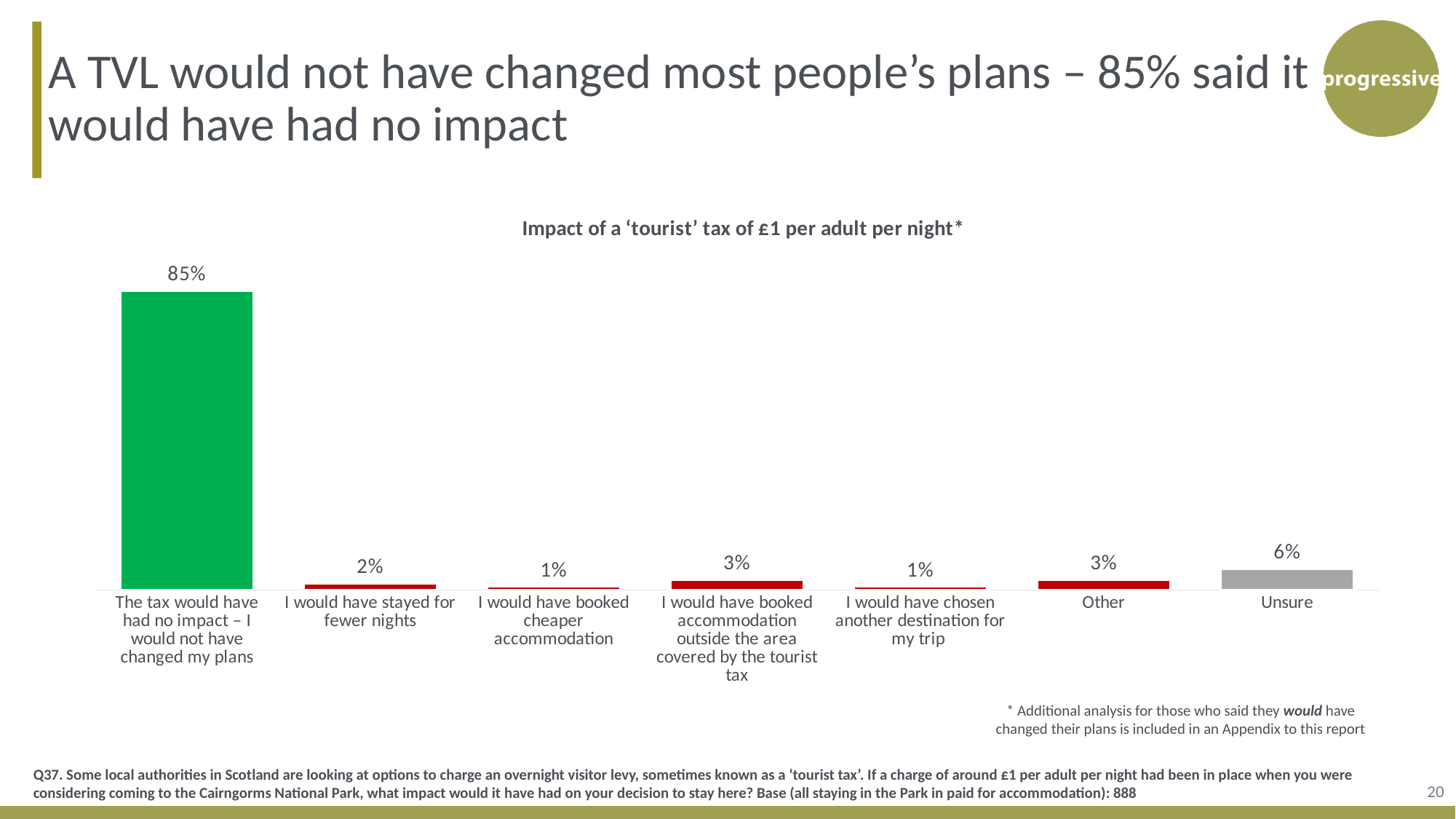
What is the value for 'I would have stayed for fewer nights'? 2% Which category has the highest value? The tax would have had no impact – I would not have changed my plans What is the value for 'Unsure'? 6% What kind of chart is shown on the slide? Bar chart What is the difference between 'The tax would have had no impact' and 'Unsure'? 79% What colour is the bar for 'The tax would have had no impact'? Green How many categories are shown in the chart? 7 Which is larger: 'I would have stayed for fewer nights' or 'Other'? Other What is the value for 'I would have booked accommodation outside the area covered by the tourist tax'? 3% What percentage of respondents said the tax would have had no impact? 85% What is the title of the chart? Impact of a ‘tourist’ tax of £1 per adult per night* What is the difference between 'Unsure' and 'Other'? 3%